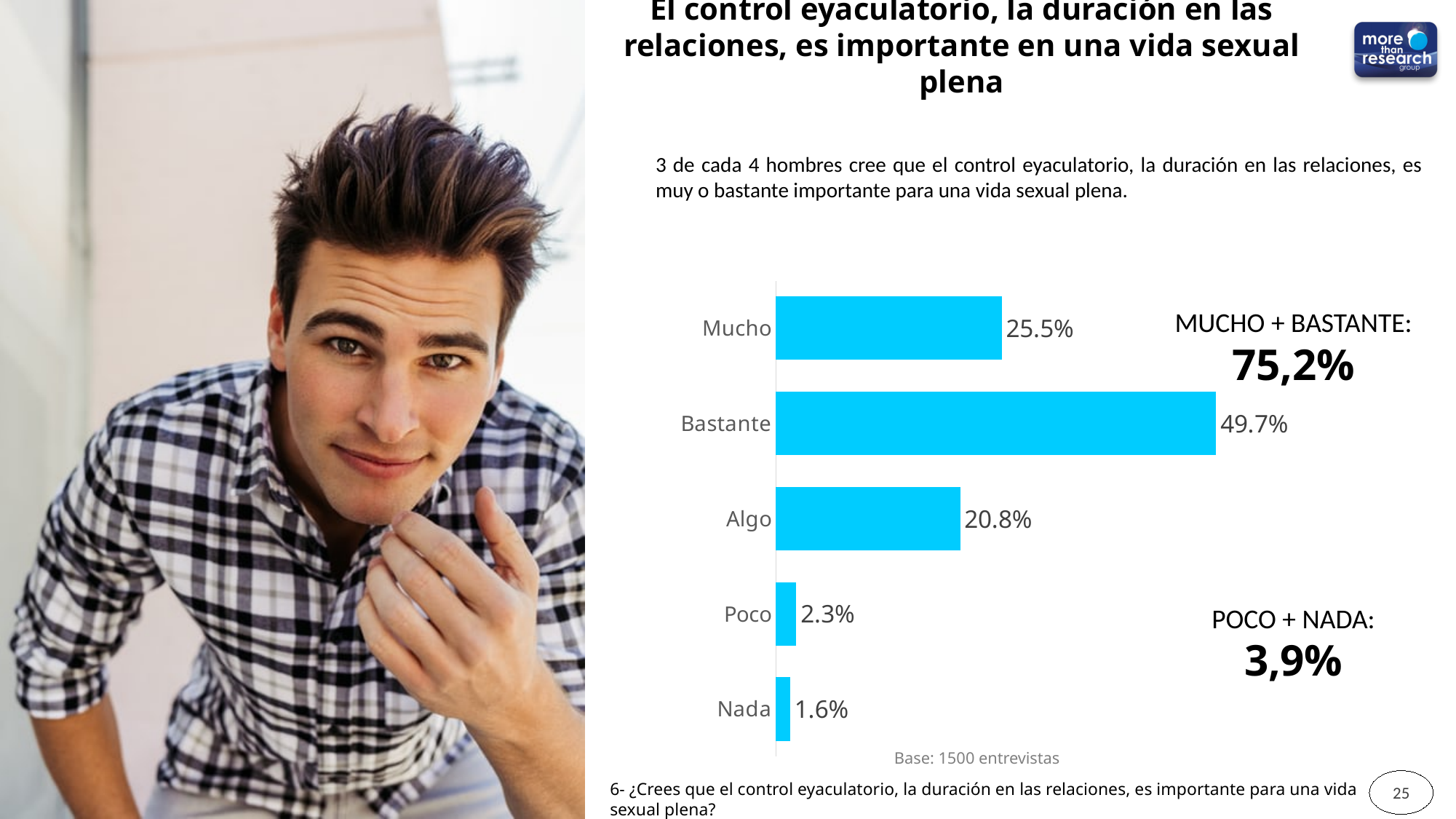
What is the value for Poco? 2.3% What is the value for Nada? 1.6% What is the difference between the values for Bastante and Mucho? 24.2% What is the value for Algo? 20.8% How many categories are shown in the chart? 5 What is the value for Bastante? 49.7% What is the combined value shown for MUCHO + BASTANTE? 75,2% Which is larger, the value for Mucho or the value for Algo? Mucho Which category has the highest value? Bastante What is the value for Mucho? 25.5% What kind of chart is shown on the slide? Bar chart Which category has the lowest value? Nada